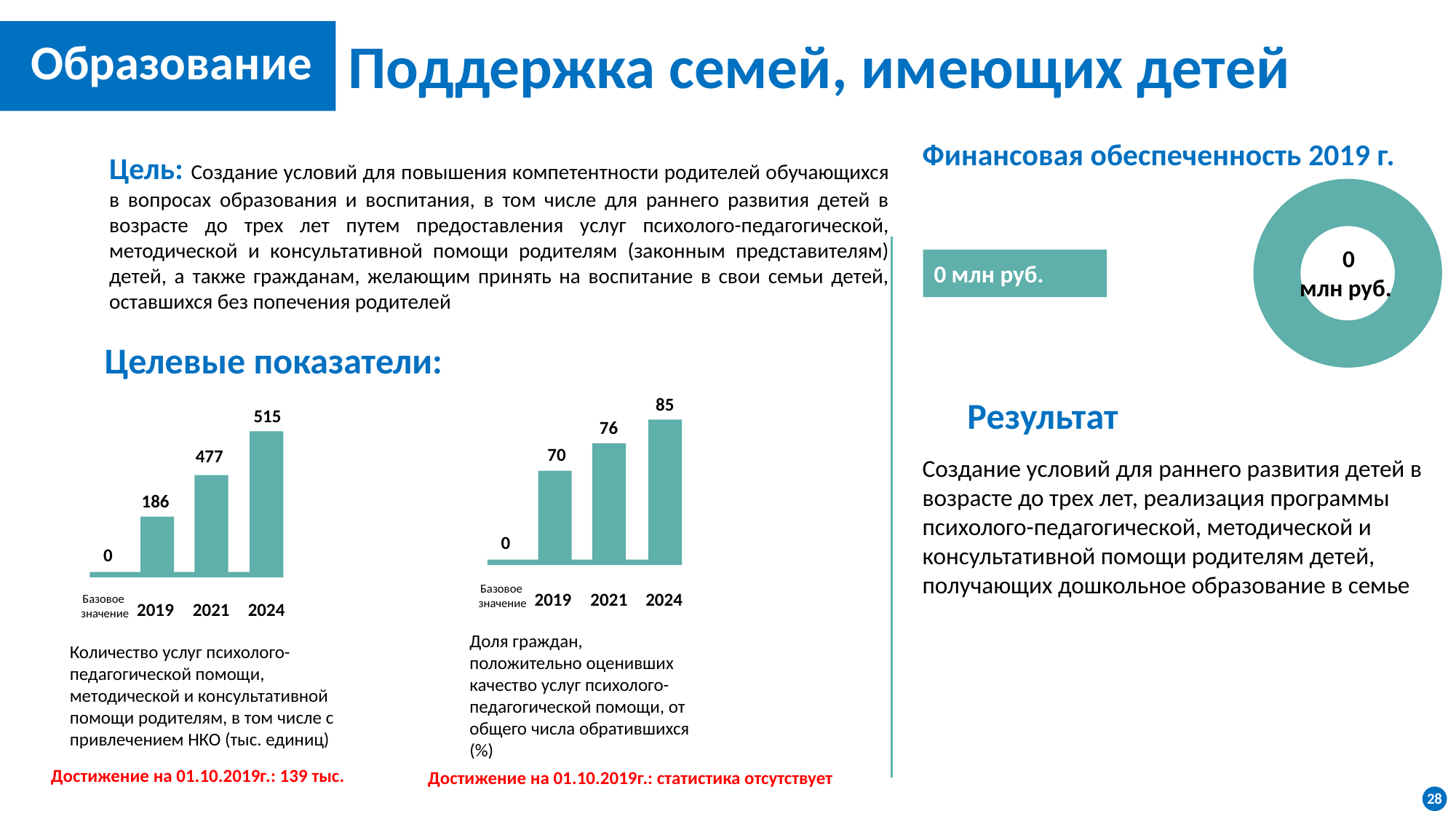
On the left bar chart (number of services, thousand units), what is the value for 2021? 477 On the middle bar chart (share of citizens who rated the quality of services positively, %), what is the value for 2021? 76 On the left bar chart (number of services, thousand units), what is the value for 2019? 186 On the left bar chart (number of services, thousand units), do the values rise or fall from the base value to 2024? rise On the left bar chart (number of services, thousand units), what is the difference between the 2024 and 2021 values? 38 On the left bar chart (number of psychological-pedagogical assistance services, thousand units), what is the value for 2024? 515 What type of chart is used for the 'Финансовая обеспеченность 2019 г.' figure on the right of the slide? donut chart On the middle bar chart (share of citizens who rated the quality of services positively, %), what is the value for 2024? 85 On the middle bar chart (share of citizens who rated the quality of services positively, %), what is the difference between the 2024 and 2019 values? 15 On the left bar chart (number of services, thousand units), which category has the lowest value? Базовое значение How many categories are shown on the middle bar chart (share of citizens who rated the quality of services positively, %)? 4 On the middle bar chart (share of citizens who rated the quality of services positively, %), which year has the highest value? 2024